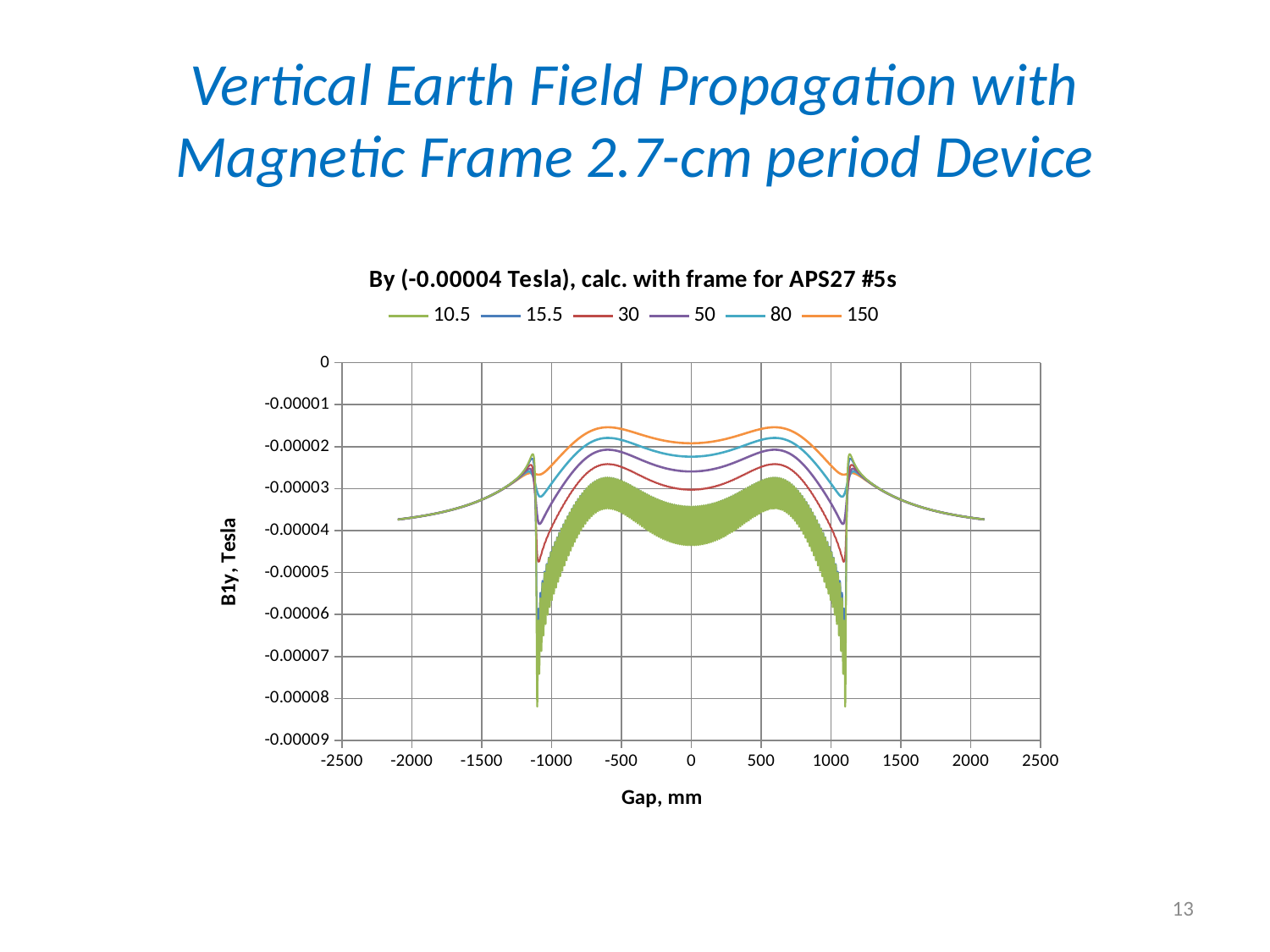
Which series has the highest value at a gap of 0 mm? 150 At a gap of 0 mm, which series has the larger value, 150 or 10.5? 150 Which series has the lowest value at a gap of 0 mm? 10.5 What is the title of the chart? By (-0.00004 Tesla), calc. with frame for APS27 #5s Is the value of the 10.5 series at a gap of 0 mm greater or less than -0.00003? less What is the label of the x axis? Gap, mm How many series does the legend list? 6 At a gap of 0 mm, which series has the larger value, 80 or 30? 80 What kind of chart is shown on the slide? line chart Which series reaches the lowest value anywhere on the chart? 10.5 Is the value of the 150 series at a gap of 0 mm greater or less than -0.00003? greater Between a gap of -2000 mm and -1500 mm, do the values rise or fall? rise